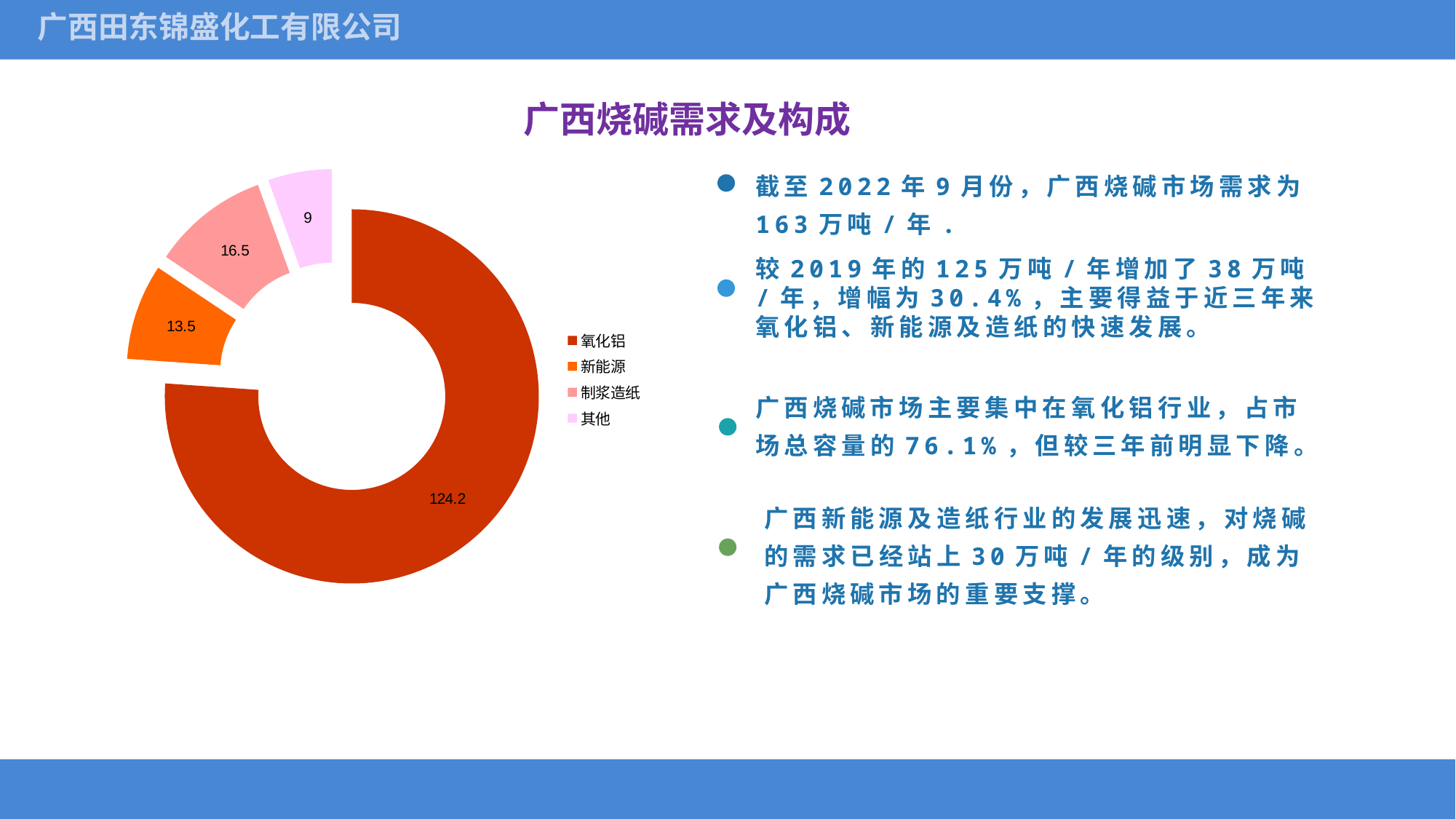
What colour is the 其他 slice in the chart? Light pink What kind of chart is shown on the slide? Doughnut (pie) chart What is the value for 制浆造纸 in the chart? 16.5 Which is larger, the value for 制浆造纸 or the value for 新能源? 制浆造纸 Which category has the largest slice in the chart? 氧化铝 What is the value for 其他 in the chart? 9 Which category has the smallest slice in the chart? 其他 What is the total of all the values shown in the chart? 163.2 What is the value for 氧化铝 in the chart? 124.2 What is the value for 新能源 in the chart? 13.5 What is the difference between the values for 制浆造纸 and 新能源? 3 How many categories does the chart show? 4